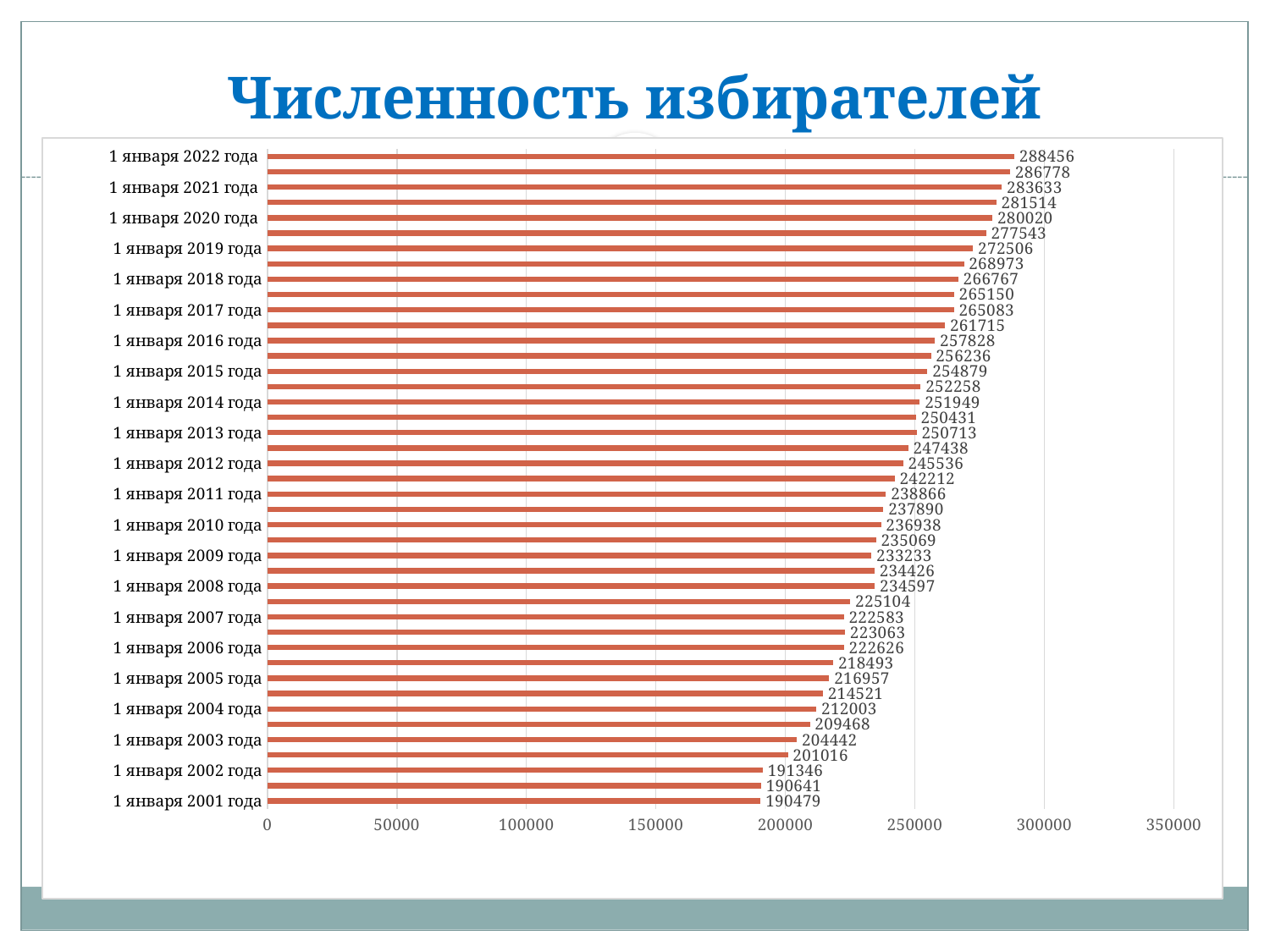
What is the value for 1 января 2022 года? 288456 What is the title of the chart? Численность избирателей Is the value for 1 января 2019 года greater or less than 250000? greater What is the value for 1 января 2001 года? 190479 What kind of chart is shown on the slide? bar chart What is the value for 1 января 2010 года? 236938 Which is larger, the value for 1 января 2015 года or 1 января 2005 года? 1 января 2015 года Which category has the highest value? 1 января 2022 года Which category has the lowest value? 1 января 2001 года What is the value for 1 января 2015 года? 254879 What is the difference between the values for 1 января 2022 года and 1 января 2001 года? 97977 Do the values rise or fall from 1 января 2001 года to 1 января 2022 года? rise